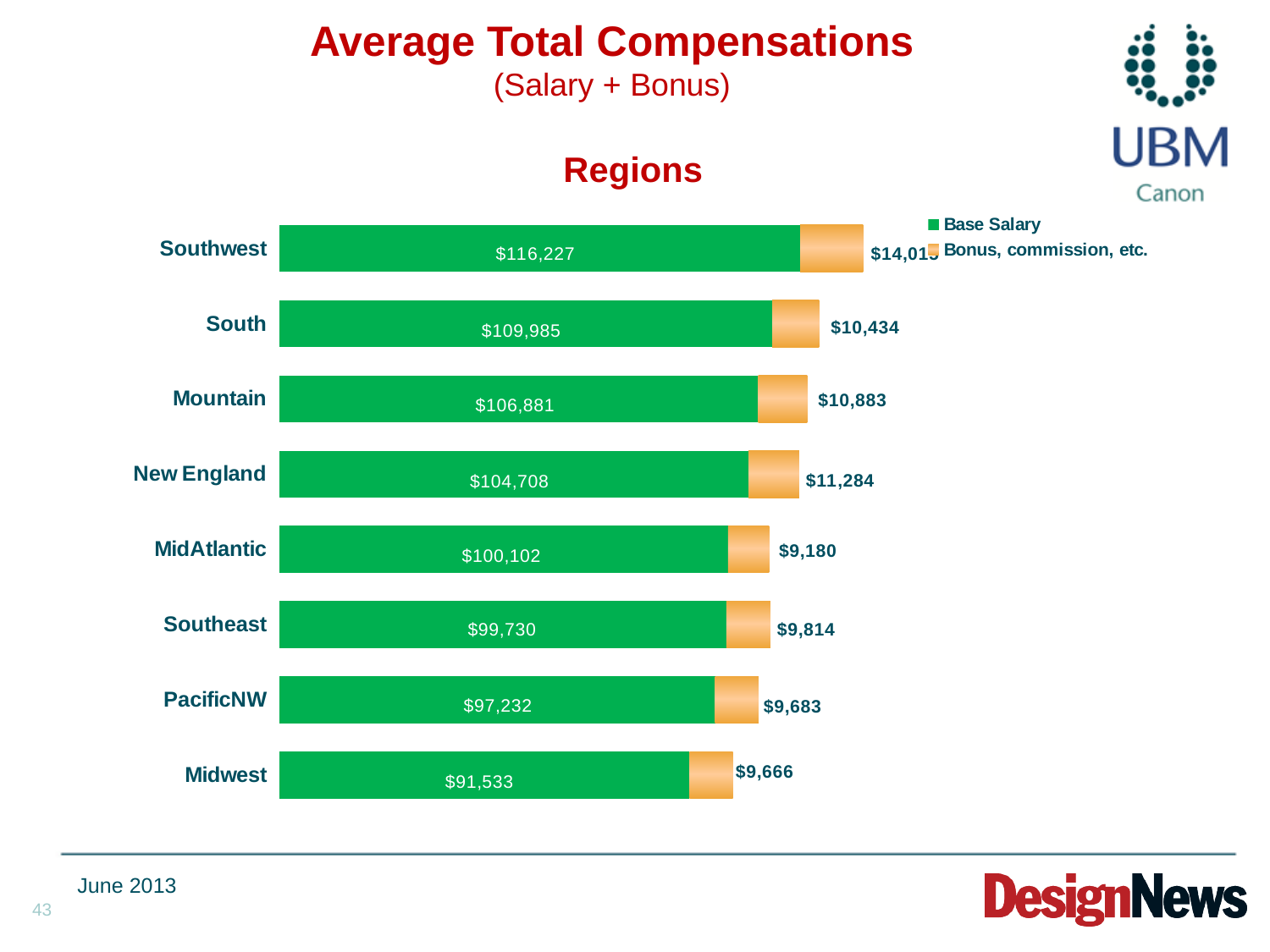
What is the bonus, commission, etc. value for New England? $11,284 Which region has the lowest base salary? Midwest Which region has a larger bonus, commission, etc. value: South or Mountain? Mountain Which region has the lowest bonus, commission, etc. value? MidAtlantic What is the difference between the base salary of the Southwest and the Midwest? $24,694 How many regions are shown in the chart? 8 What is the base salary for the Mountain region? $106,881 How many series does the legend list? 2 Which region has the highest base salary? Southwest What kind of chart is shown on the slide? Stacked bar chart What is the base salary for the Midwest region? $91,533 What is the total compensation (base salary plus bonus) for the South region? $120,419